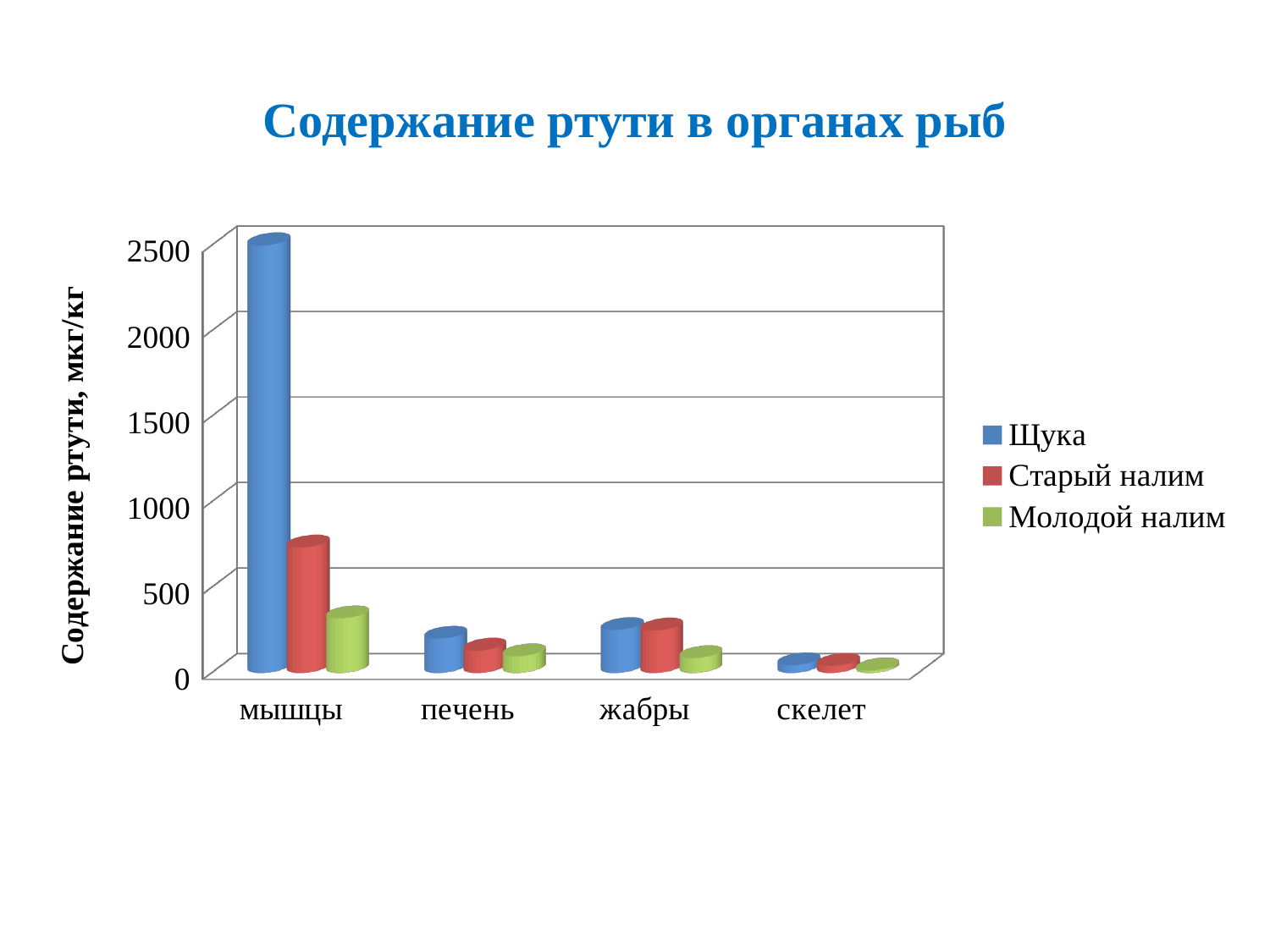
Is the value for Молодой налим in мышцы greater or less than 500? less Which category has the highest value for Щука? мышцы Is the value for Щука in мышцы greater or less than 2000? greater What kind of chart is shown on the slide? bar chart How many organ categories are shown on the x axis? 4 What is the title of the chart? Содержание ртути в органах рыб In the мышцы category, which is larger: the value for Щука or for Старый налим? Щука Is the value for Щука in печень greater or less than 500? less What is the label of the vertical axis? Содержание ртути, мкг/кг Which category has the lowest value for Щука? скелет How many series does the legend list? 3